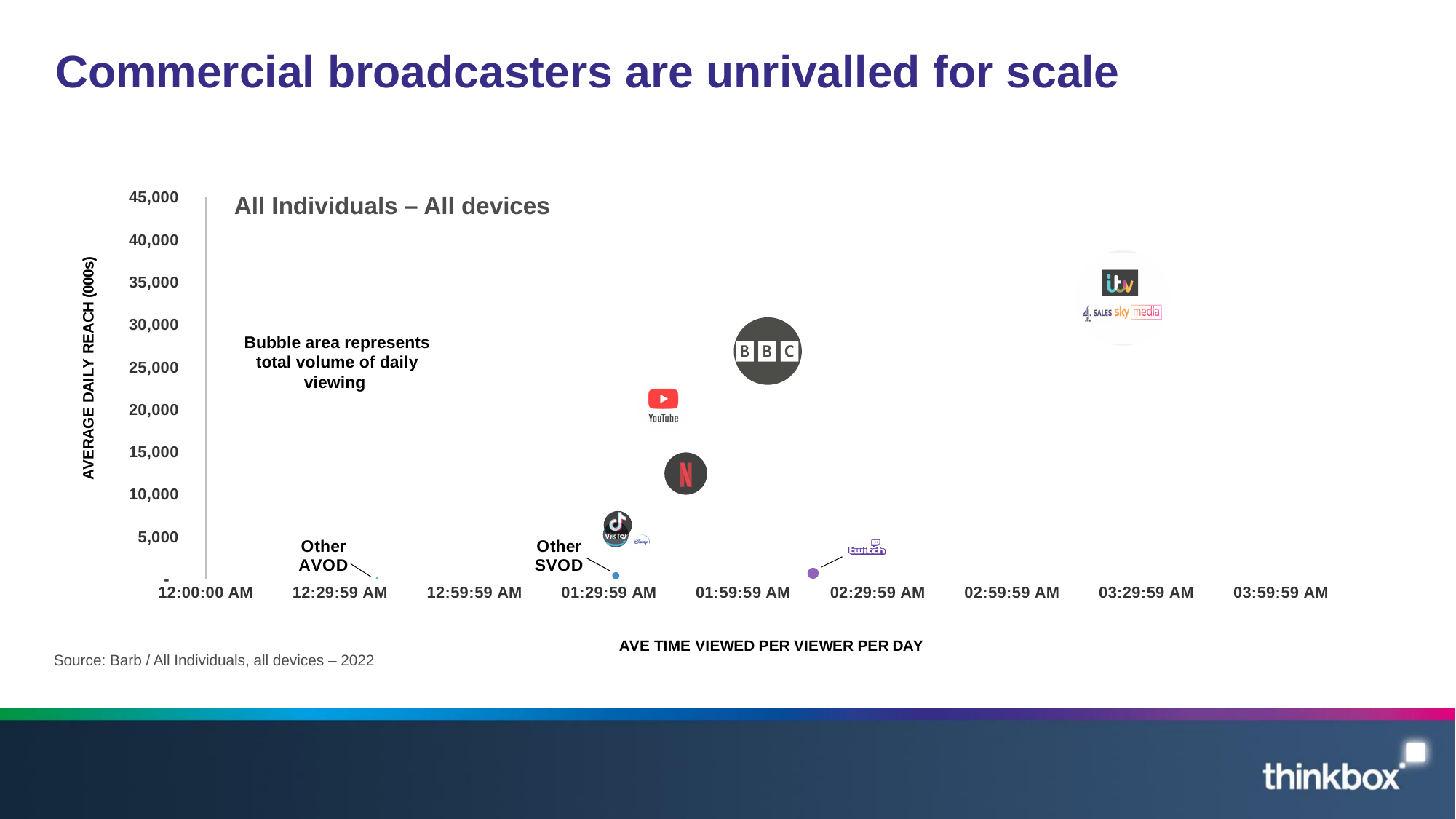
Which has the larger average daily reach, YouTube or Netflix? YouTube Which bubble has the highest average daily reach? The commercial broadcasters (ITV, Channel 4 Sales, Sky Media) Is the average daily reach for the commercial broadcasters (ITV, Channel 4 Sales, Sky Media) greater or less than 30,000? greater According to the note on the chart, what does the bubble area represent? Total volume of daily viewing What is the title printed inside the chart area? All Individuals – All devices Which has the larger average daily reach, BBC or YouTube? BBC Is the average daily reach for Twitch greater or less than 5,000? less Which has the longer average time viewed per viewer per day, Twitch or Netflix? Twitch Is the average daily reach for BBC greater or less than 25,000? greater Which bubble has the lowest average time viewed per viewer per day? Other AVOD What kind of chart is shown on the slide? Bubble chart